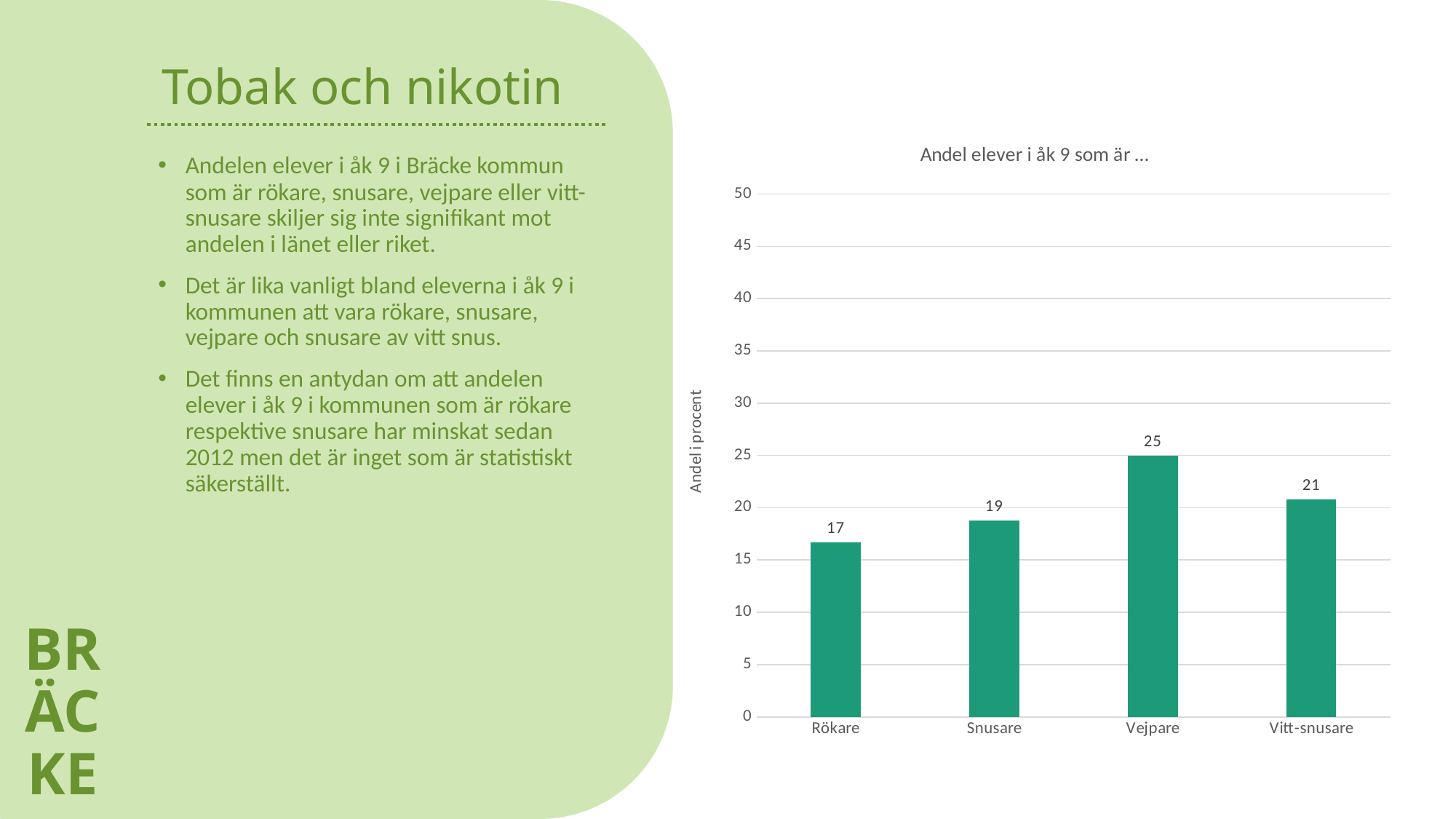
What is the value for Snusare? 19 Which category has the lowest value? Rökare Which is larger, the value for Vitt-snusare or the value for Snusare? Vitt-snusare What kind of chart is shown on the slide? bar chart What is the value for Vitt-snusare? 21 Is the value for Vejpare greater or less than 20? greater How many categories are shown on the x axis? 4 What is the value for Vejpare? 25 What is the title of the chart? Andel elever i åk 9 som är … What is the value for Rökare? 17 What is the difference between the values for Vejpare and Rökare? 8 Which category has the highest value? Vejpare